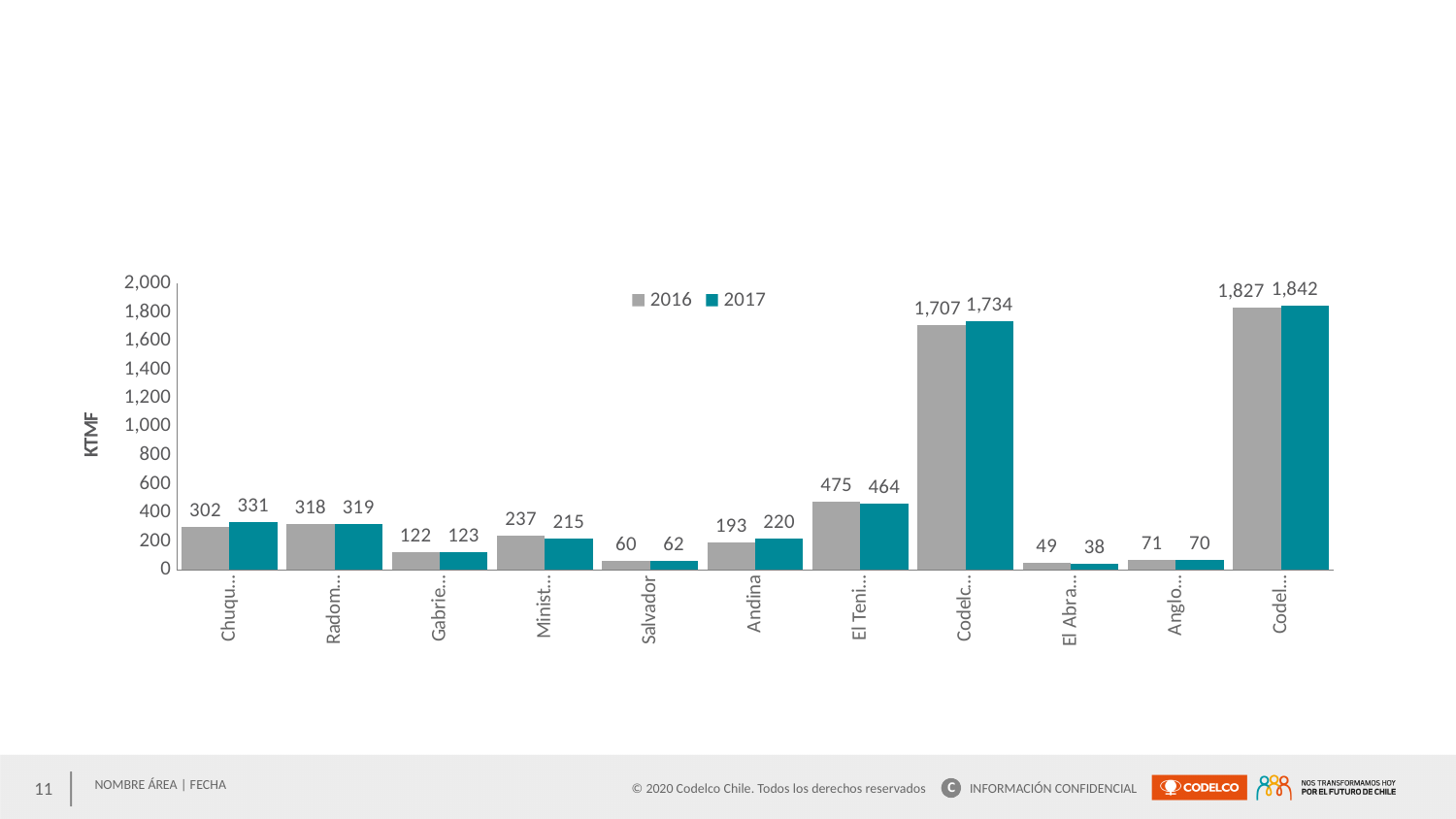
What kind of chart is shown on the slide? bar chart How many categories are shown on the x axis? 11 Is the 2016 value for Andina greater or less than 200? less What is the difference between the 2017 and 2016 values for Salvador? 2 For Salvador, which year has the larger value, 2016 or 2017? 2017 By how much did the value for Andina increase from 2016 to 2017? 27 What is the value for Salvador in 2016? 60 What is the value for Andina in 2016? 193 What is the highest value shown for the 2017 series? 1,842 What is the value for Andina in 2017? 220 What is the lowest value shown for the 2016 series? 49 How many series does the legend list? 2